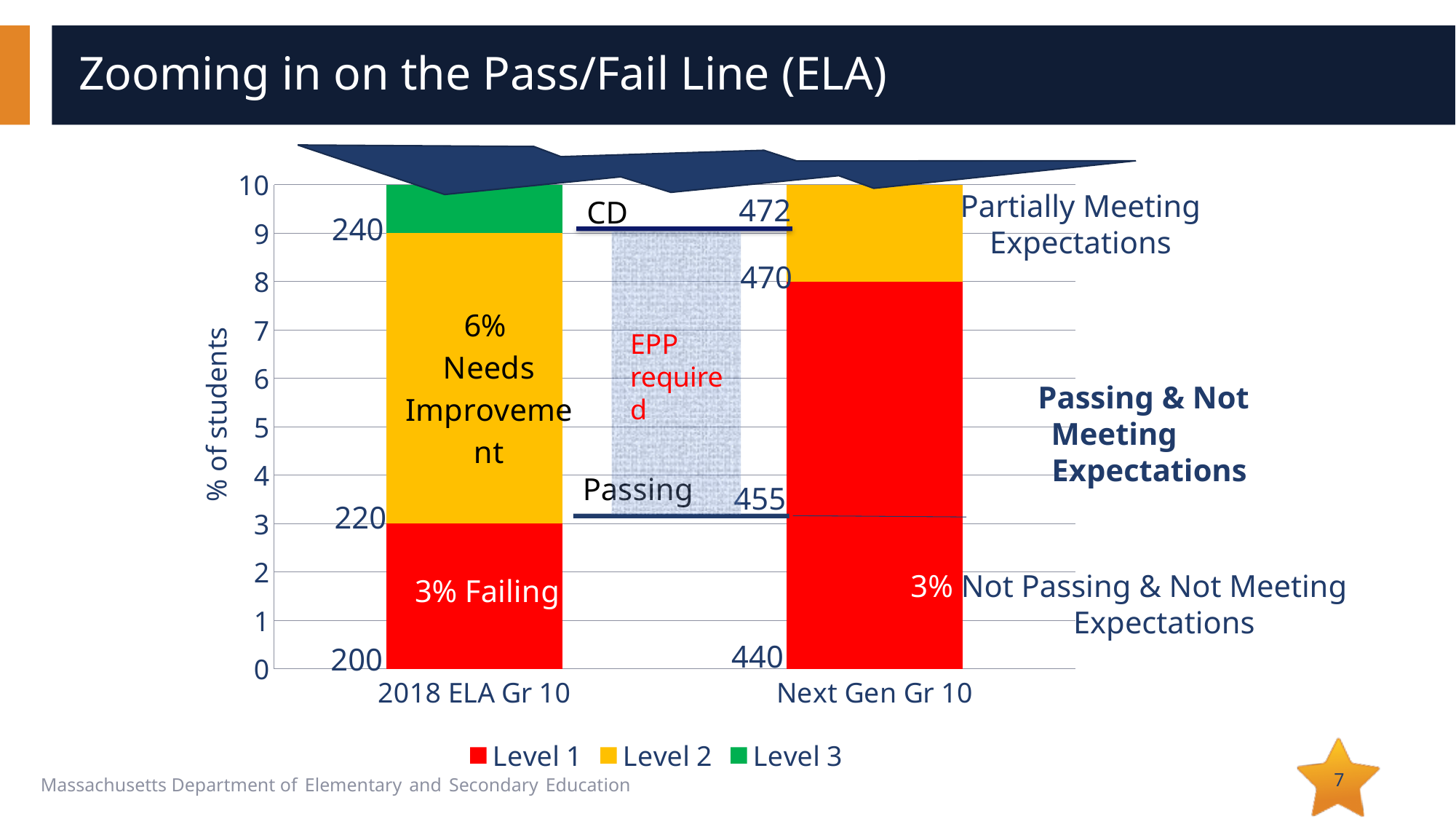
Is the Level 1 value for Next Gen Gr 10 greater or less than 5? greater How many series does the legend list? 3 What is the Level 2 value for 2018 ELA Gr 10? 6% What is the Level 1 value for 2018 ELA Gr 10? 3% Is the Level 2 value for Next Gen Gr 10 greater or less than 4? less What kind of chart is shown on the slide? bar chart Is the Level 3 value for 2018 ELA Gr 10 greater or less than 2? less Which category has the larger Level 2 segment, 2018 ELA Gr 10 or Next Gen Gr 10? 2018 ELA Gr 10 Which category has the larger Level 1 segment, 2018 ELA Gr 10 or Next Gen Gr 10? Next Gen Gr 10 What is the title of the y axis? % of students What are the entries listed in the legend? Level 1, Level 2, Level 3 How many categories are shown on the x axis? 2